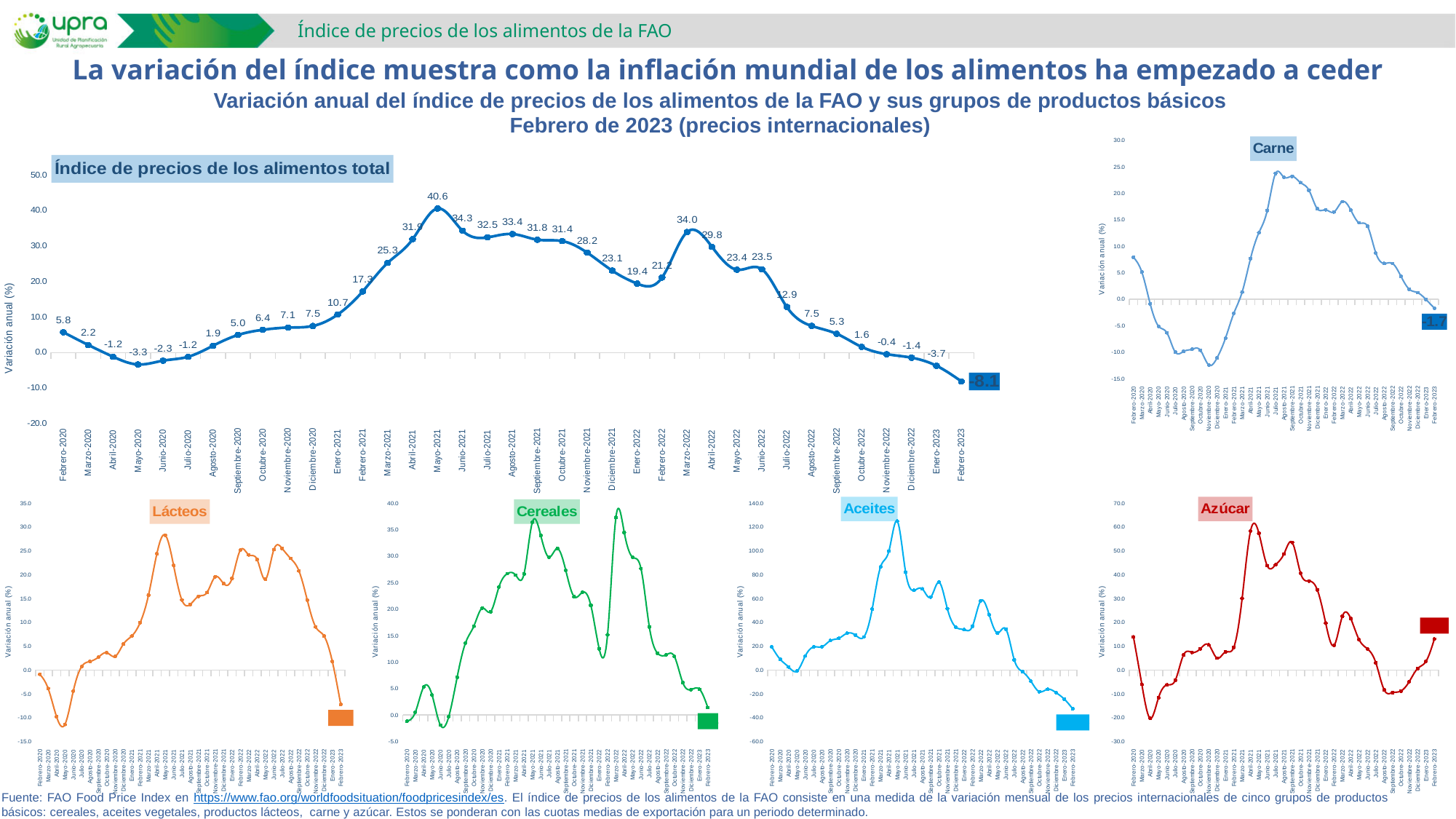
In the 'Carne' chart, what is the value for Febrero-2023? -1.7 In the 'Índice de precios de los alimentos total' chart, what is the value for Febrero-2023? -8.1 In the 'Índice de precios de los alimentos total' chart, what is the value for Marzo-2022? 34.0 How many monthly data points are plotted in the 'Índice de precios de los alimentos total' chart? 37 What kind of chart is the 'Índice de precios de los alimentos total' chart? Line chart In the 'Índice de precios de los alimentos total' chart, which month has the lowest value? Febrero-2023 In the 'Índice de precios de los alimentos total' chart, which is larger: the value for Junio-2021 or Marzo-2022? Junio-2021 In the 'Aceites' chart, is the value for Febrero-2023 greater or less than 0? less In the 'Índice de precios de los alimentos total' chart, what is the difference between the values for Mayo-2021 and Febrero-2023? 48.7 In the 'Índice de precios de los alimentos total' chart, which month has the highest value? Mayo-2021 In the 'Índice de precios de los alimentos total' chart, do the values rise or fall from Mayo-2020 to Mayo-2021? Rise In the 'Índice de precios de los alimentos total' chart, what is the value for Mayo-2021? 40.6